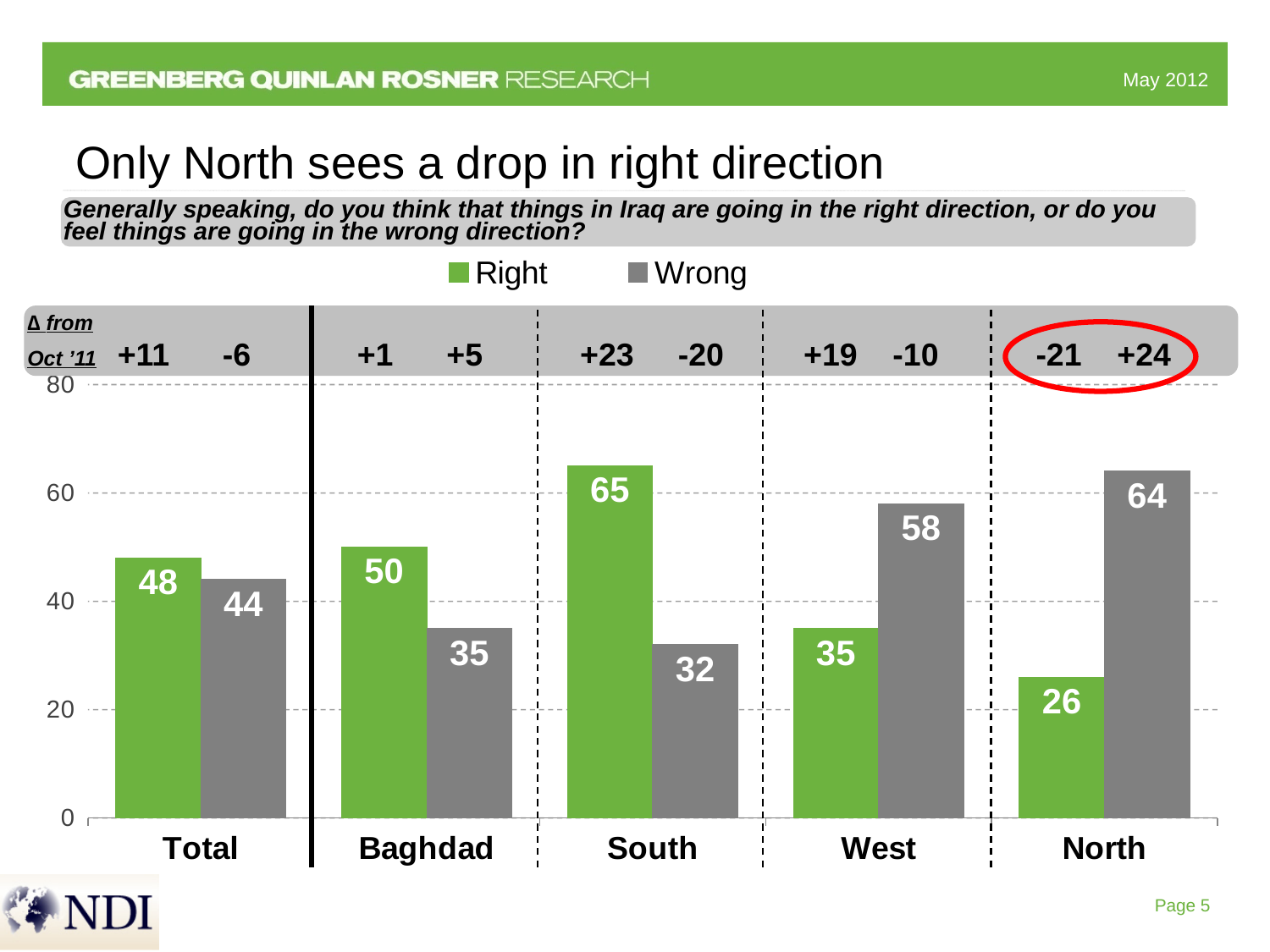
Which region has the highest value for Right? South How many series does the legend list? 2 What colour represents the Wrong series? grey What is the value for Wrong in the North? 64 What is the value for Right in the South? 65 Which region has the lowest value for Right? North What is the difference between Wrong and Right in the West? 23 How many categories are shown on the x axis? 5 What is the value for Right in Baghdad? 50 What kind of chart is shown on the slide? bar chart Is the value for Wrong in the South greater or less than 40? less Which is larger in the Total group, Right or Wrong? Right